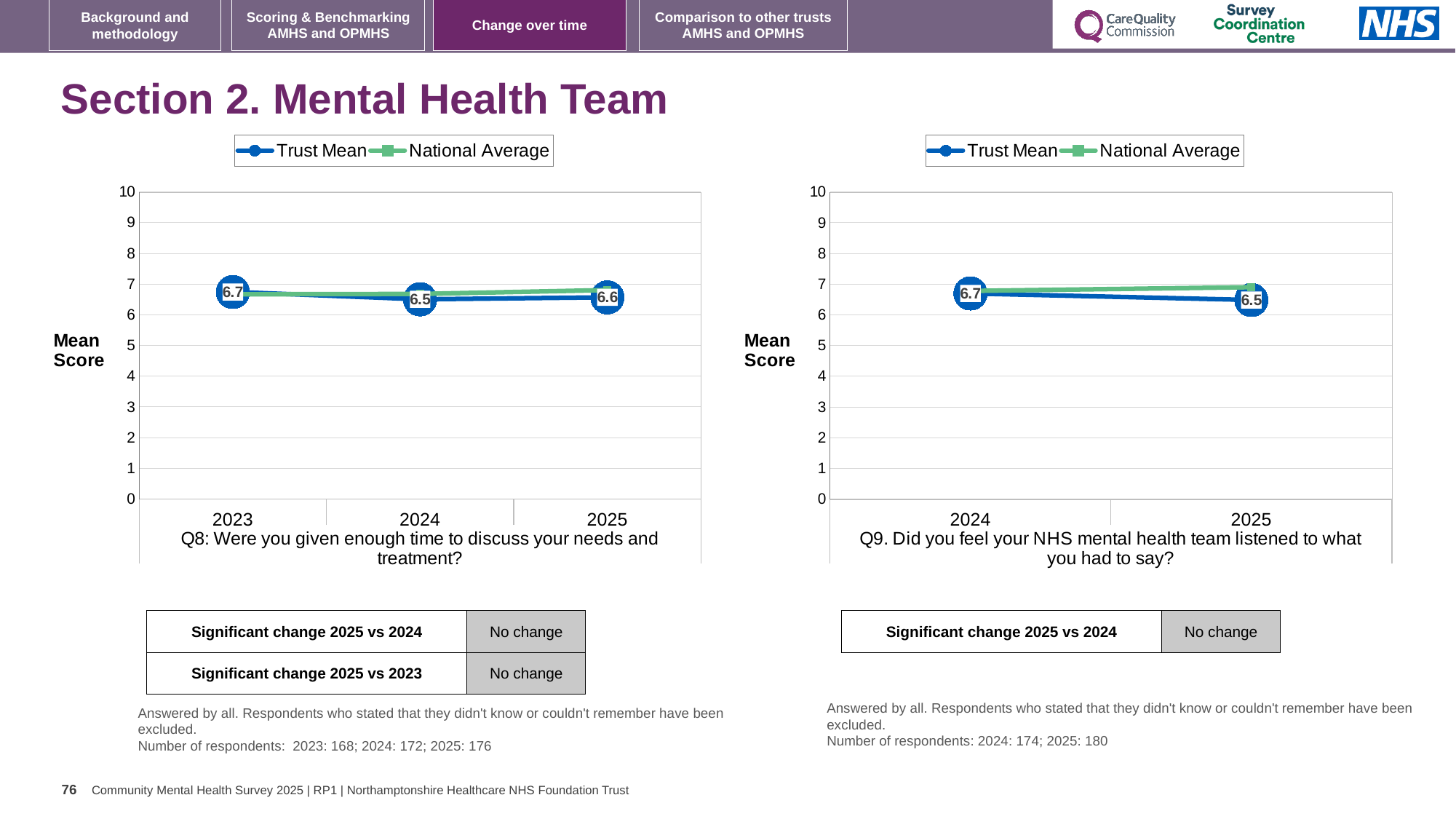
On the Q8 chart (left), what is the Trust Mean score for 2025? 6.6 On the Q8 chart (left), which year has the highest Trust Mean score? 2023 What type of chart is the Q9 chart (right)? Line chart How many years are plotted on the Q8 chart (left)? 3 On the Q8 chart (left), which year has the lowest Trust Mean score? 2024 On the Q8 chart (left), what is the Trust Mean score for 2023? 6.7 On the Q9 chart (right), what is the Trust Mean score for 2025? 6.5 On the Q8 chart (left), what is the difference between the Trust Mean scores for 2023 and 2024? 0.2 On the Q8 chart (left), what is the Trust Mean score for 2024? 6.5 How many series does the legend of the Q9 chart (right) list? 2 On the Q9 chart (right), what is the difference between the Trust Mean scores for 2024 and 2025? 0.2 On the Q9 chart (right), what is the Trust Mean score for 2024? 6.7